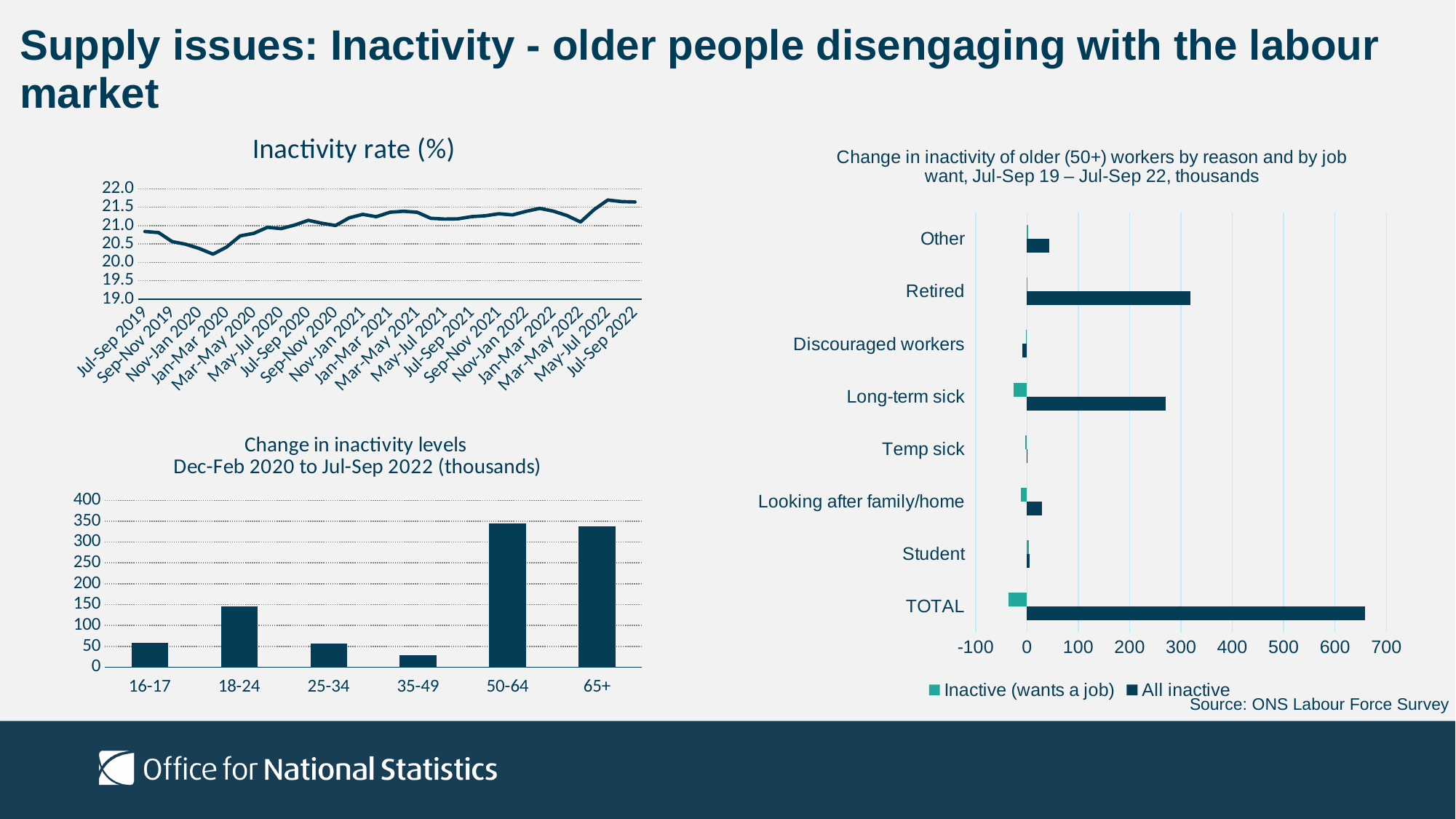
What kind of chart is the 'Inactivity rate (%)' chart? line chart On the 'Change in inactivity levels' chart, is the value for 18-24 greater or less than 100? greater How many age groups are shown on the 'Change in inactivity levels' bar chart? 6 How many series does the legend list on the 'Change in inactivity of older (50+) workers by reason and by job want' chart? 2 On the 'Change in inactivity of older (50+) workers' chart, which is larger for 'All inactive': Retired or Long-term sick? Retired On the 'Inactivity rate (%)' chart, is the value for Jul-Sep 2022 greater or less than 21.5? greater On the 'Change in inactivity levels' chart, which age group has the lowest value? 35-49 On the 'Change in inactivity levels' chart, is the value for 50-64 greater or less than 300? greater What kind of chart is 'Change in inactivity levels Dec-Feb 2020 to Jul-Sep 2022 (thousands)'? bar chart